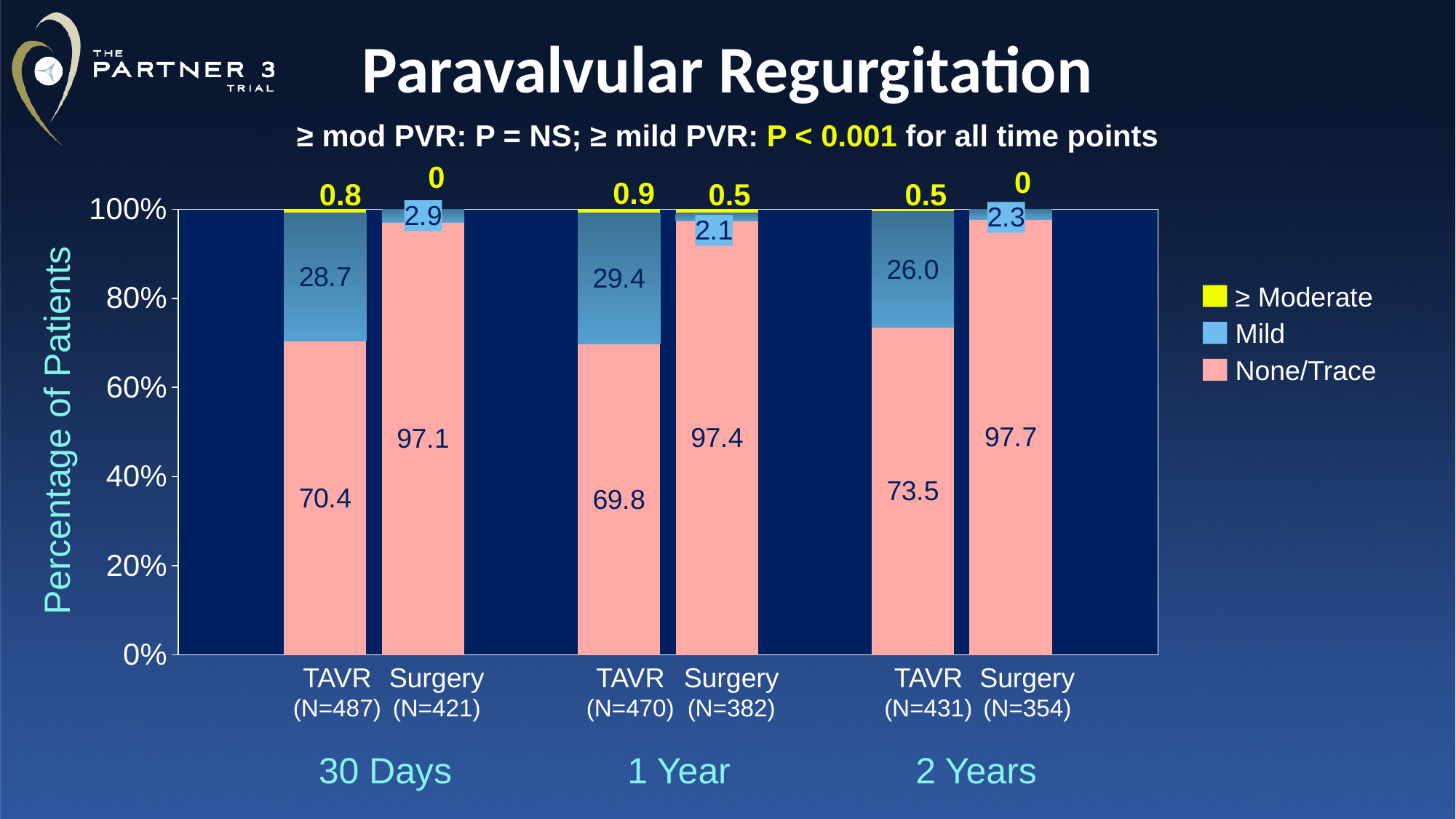
What is the None/Trace value for TAVR at 30 Days? 70.4 What is the ≥ Moderate value for TAVR at 2 Years? 0.5 What is the difference between the Mild values for TAVR and Surgery at 30 Days? 25.8 Which has a larger Mild value: TAVR at 1 Year or TAVR at 2 Years? TAVR at 1 Year How many series does the legend list? 3 What is the difference between the None/Trace values for Surgery and TAVR at 2 Years? 24.2 What is the Mild value for Surgery at 1 Year? 2.1 How many bars are plotted in the chart? 6 What kind of chart is shown on the slide? Stacked bar chart Which bar has the highest None/Trace value? Surgery at 2 Years Which bar has the lowest None/Trace value? TAVR at 1 Year What is the ≥ Moderate value for Surgery at 30 Days? 0